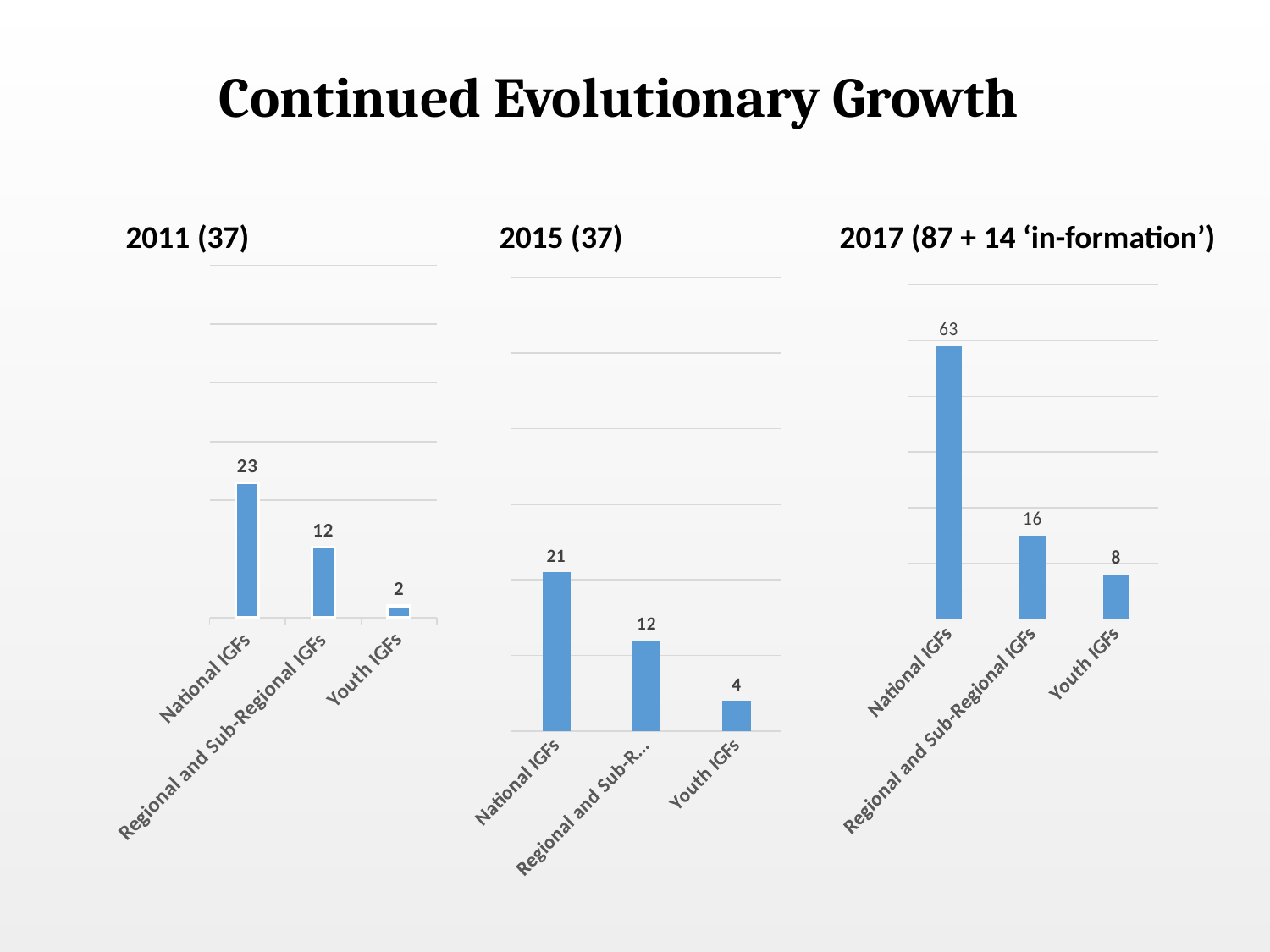
What kind of chart is the 2017 chart? Bar chart In the 2017 chart, what is the difference between National IGFs and Youth IGFs? 55 In the 2015 (37) chart, what is the difference between National IGFs and Regional and Sub-Regional IGFs? 9 In the 2017 chart, what is the value for Regional and Sub-Regional IGFs? 16 In the 2015 (37) chart, what is the value for Youth IGFs? 4 In the 2011 (37) chart, what is the value for National IGFs? 23 In the 2011 (37) chart, which category has the lowest value? Youth IGFs Which is larger: National IGFs in the 2011 chart or National IGFs in the 2015 chart? National IGFs in the 2011 chart What is the title of the slide? Continued Evolutionary Growth How many categories are shown in the 2015 (37) chart? 3 In the 2017 chart, which category has the highest value? National IGFs In the 2017 chart, do the values rise or fall from left to right across the categories? Fall